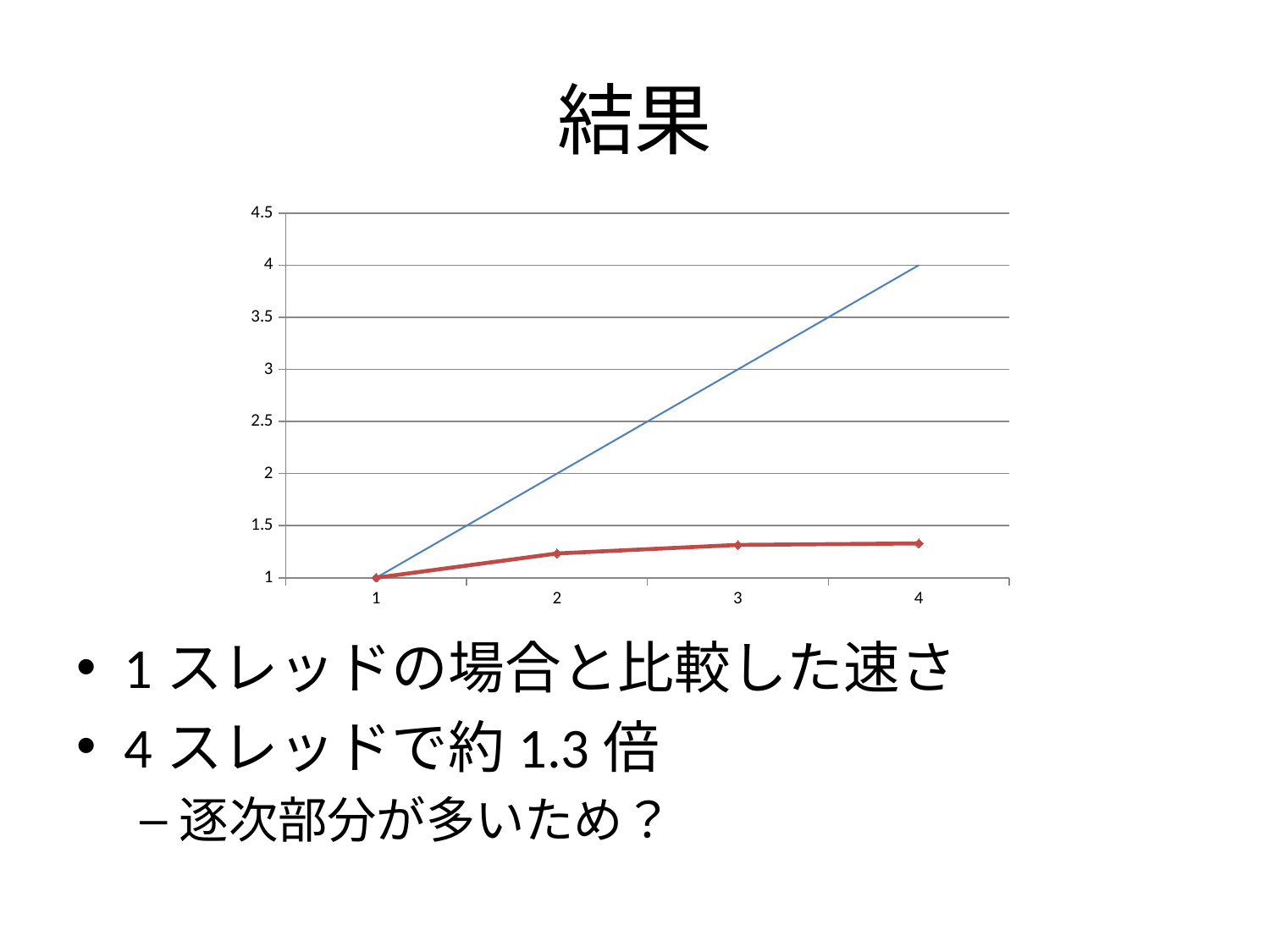
At x = 4, which line has the larger value, the blue line or the red line? blue line What is the highest tick value shown on the y axis? 4.5 What is the value of the red line at x = 1? 1 What kind of chart is shown on the slide? line chart Does the red line rise or fall as x increases from 1 to 4? rise Is the value of the red line at x = 2 greater or less than 1.5? less What is the difference between the blue line's value at x = 4 and at x = 1? 3 What is the value of the blue line at x = 4? 4 Is the value of the red line at x = 4 greater or less than 1.5? less Is the value of the blue line at x = 3 greater or less than 2.5? greater What is the value of the blue line at x = 2? 2 How many points are marked along the x axis of the chart? 4